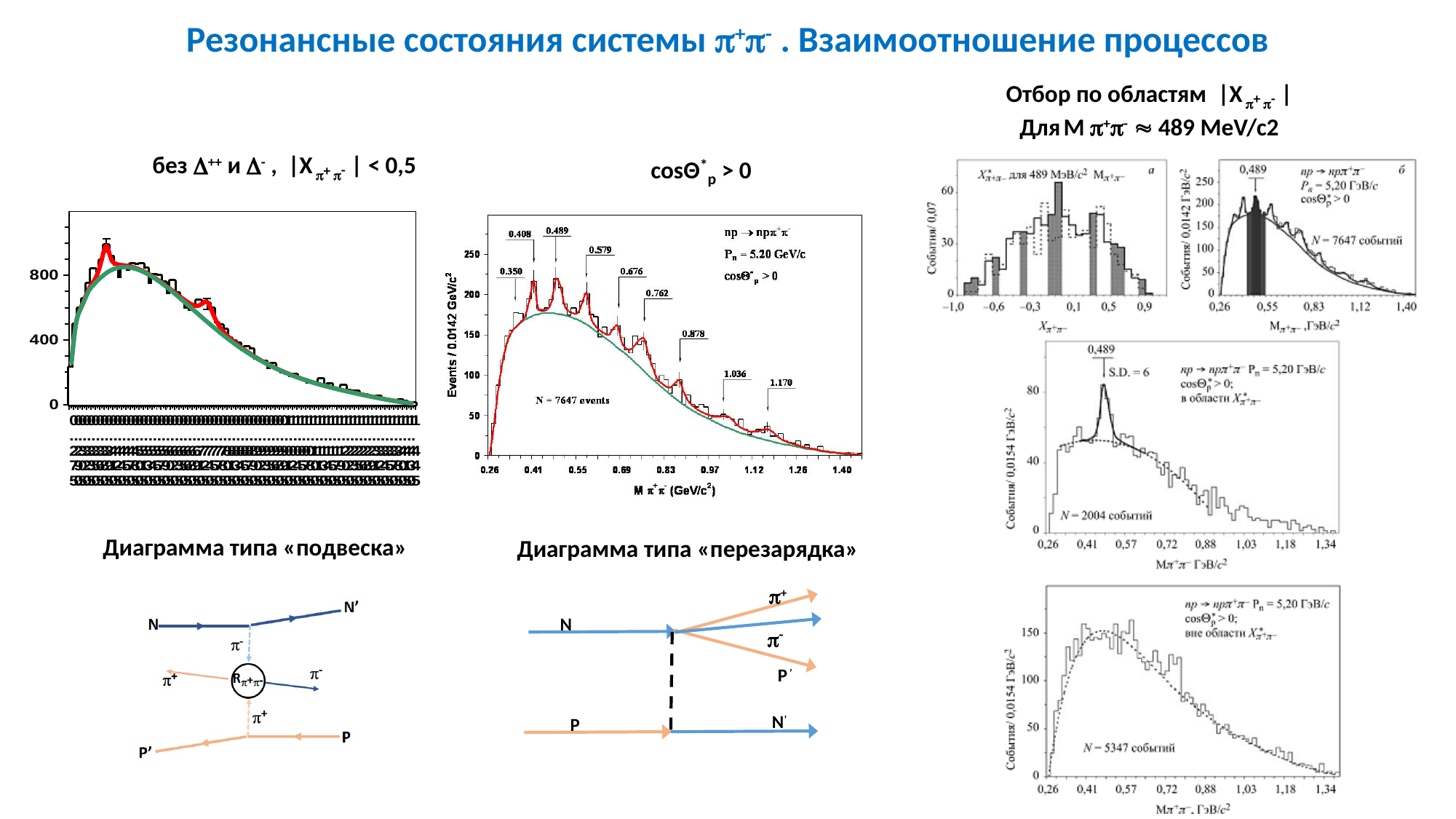
In the middle chart (cosΘ*p > 0), what beam momentum Pn is stated? 5.20 GeV/c In the middle chart (cosΘ*p > 0), is the peak at 1.170 greater or less than 100 events? less In the middle chart (cosΘ*p > 0), which peak is higher: the one at 0.489 or the one at 1.170? 0.489 In the middle chart (cosΘ*p > 0), what is the lowest labelled peak mass? 0.350 In the right-hand bottom chart (вне области X*π+π-), do the values rise or fall along the x axis from 0.72 to 1.34 GeV/c²? fall In the middle chart (cosΘ*p > 0), how many labelled peaks are marked on the distribution? 9 In the middle chart (cosΘ*p > 0), is the peak at 0.489 greater or less than 200 events? greater In the middle chart (cosΘ*p > 0), what is the highest labelled peak mass? 1.170 What is the difference between the number of events in the right-hand bottom chart (5347) and the right-hand middle chart (2004)? 3343 In the middle chart (cosΘ*p > 0), how many events (N) are stated? N = 7647 events In the right-hand middle chart (в области X*π+π-), how many events N are stated? N = 2004 событий In the right-hand bottom chart (вне области X*π+π-), how many events N are stated? N = 5347 событий